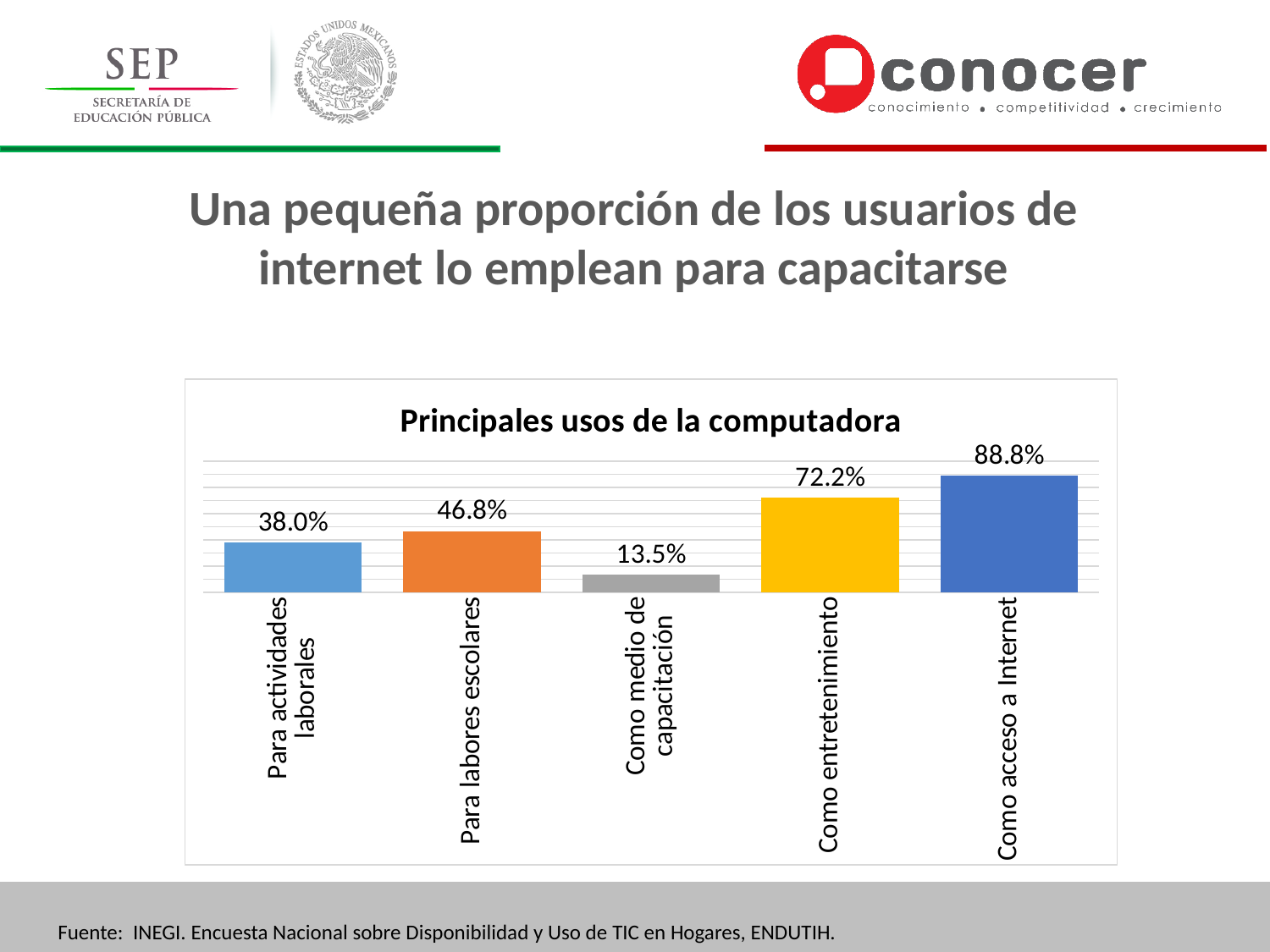
What is the difference between the values for "Para labores escolares" and "Para actividades laborales"? 8.8% What kind of chart is shown on the slide? Bar chart Which is larger, the value for "Como entretenimiento" or the value for "Para labores escolares"? Como entretenimiento What is the value for "Para actividades laborales"? 38.0% How many categories are shown in the chart? 5 What is the difference between the values for "Como acceso a Internet" and "Como entretenimiento"? 16.6% Which category has the highest value? Como acceso a Internet What is the value for "Para labores escolares"? 46.8% Which category has the lowest value? Como medio de capacitación What is the title of the chart? Principales usos de la computadora What is the value for "Como acceso a Internet"? 88.8% What is the value for "Como medio de capacitación"? 13.5%